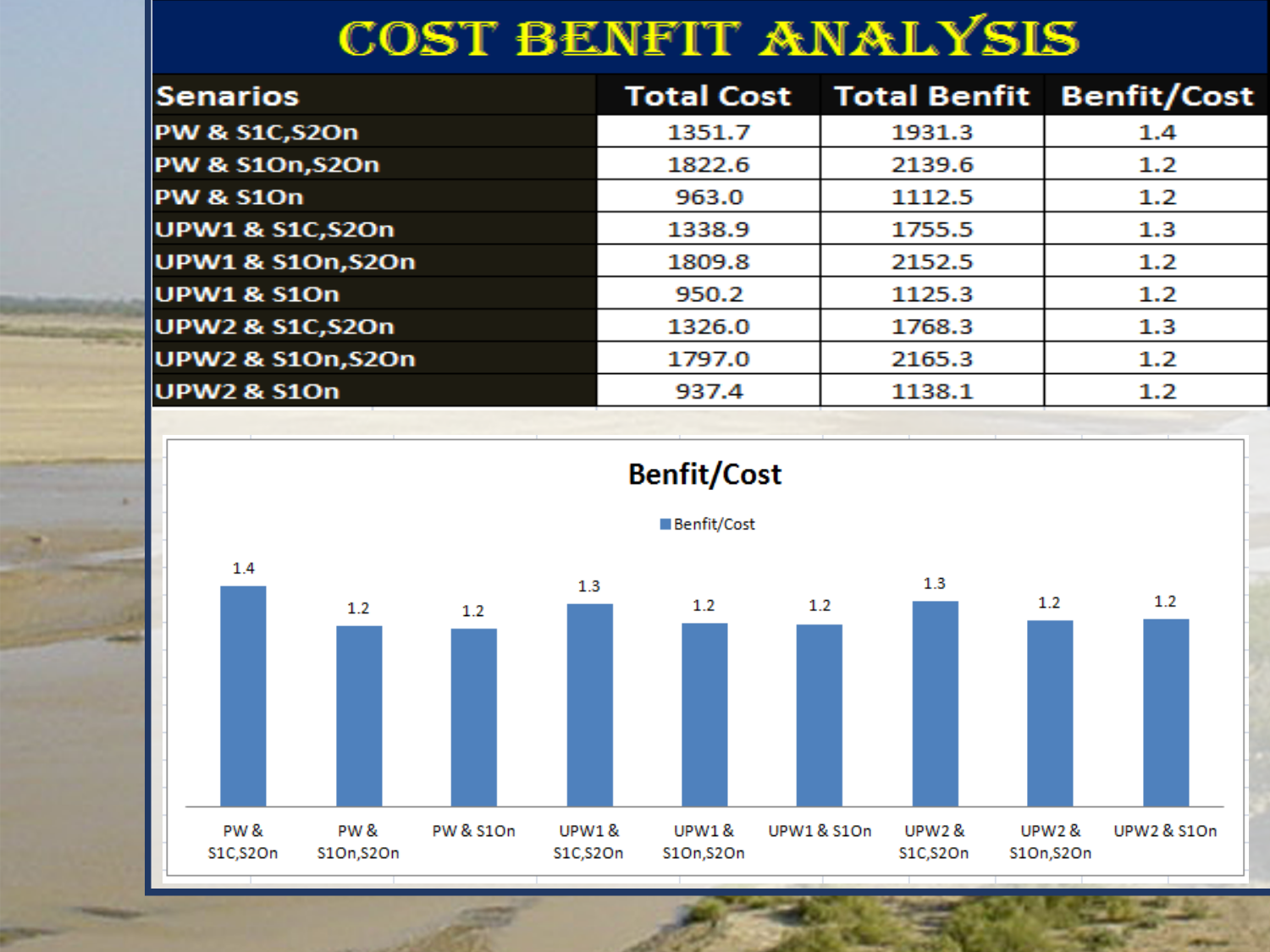
What is the Benfit/Cost value for UPW2 & S1On in the chart? 1.2 Which has a larger Benfit/Cost value, UPW2 & S1C,S2On or UPW2 & S1On,S2On? UPW2 & S1C,S2On What is the Benfit/Cost value for UPW2 & S1C,S2On in the chart? 1.3 Which scenario has the highest Benfit/Cost value in the chart? PW & S1C,S2On What is the Benfit/Cost value for UPW1 & S1C,S2On in the chart? 1.3 How many scenarios are plotted in the Benfit/Cost chart? 9 What is the Benfit/Cost value for PW & S1C,S2On in the chart? 1.4 How many series does the legend of the chart list? 1 What is the difference between the Benfit/Cost values for PW & S1C,S2On and PW & S1On,S2On? 0.2 Which has a larger Benfit/Cost value, PW & S1C,S2On or UPW1 & S1C,S2On? PW & S1C,S2On What kind of chart is shown on the slide? Bar chart What is the difference between the Benfit/Cost values for UPW1 & S1C,S2On and UPW1 & S1On? 0.1